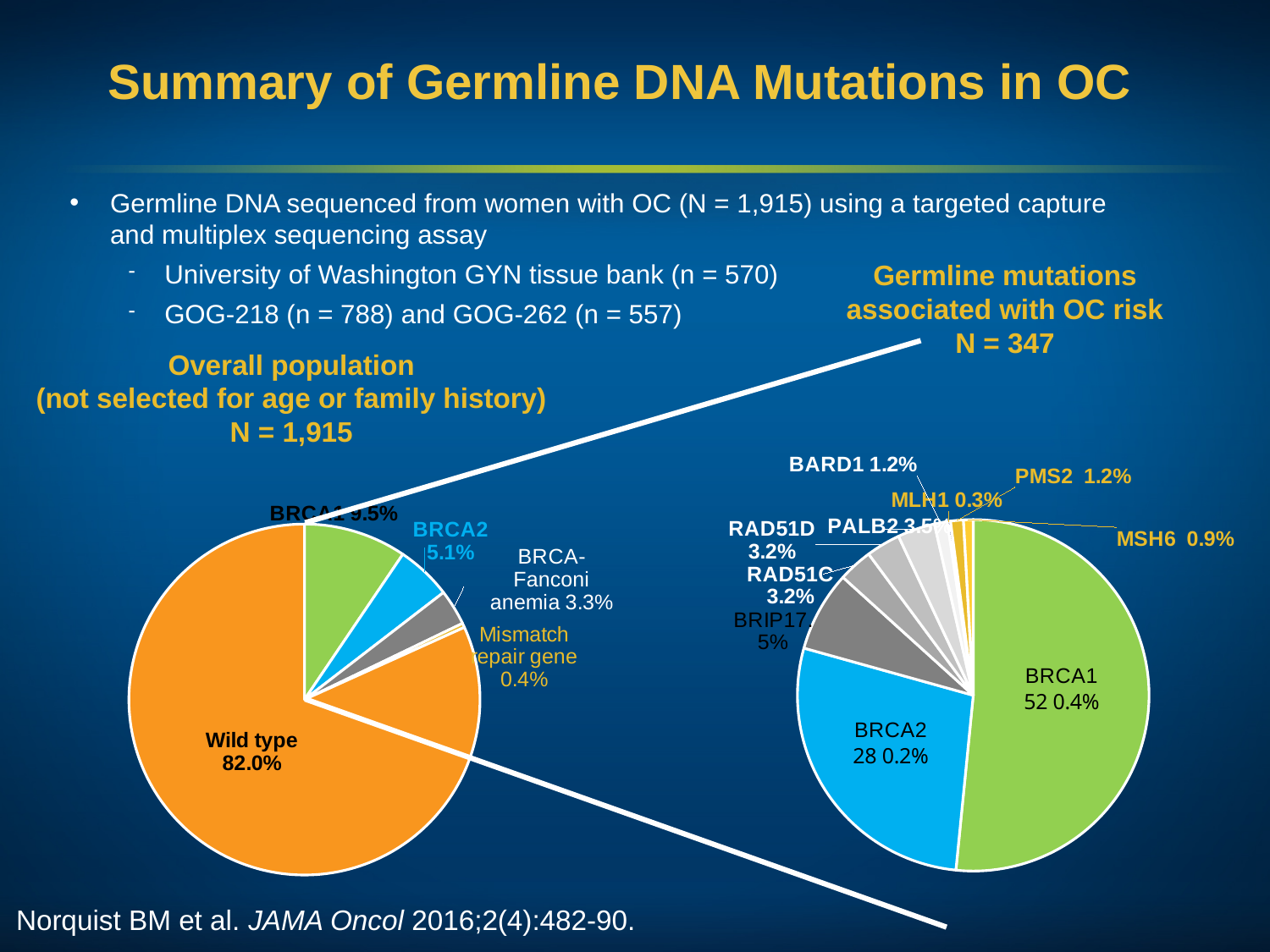
In the Germline mutations associated with OC risk pie chart on the right, what percentage is labelled for MSH6? 0.9% What kind of chart is used for the Overall population (N = 1,915) on the left of the slide? pie chart In the Overall population pie chart on the left, what percentage is labelled for BRCA2? 5.1% In the Germline mutations associated with OC risk pie chart on the right, which slice is the largest? BRCA1 In the Overall population pie chart on the left, what percentage is labelled for BRCA-Fanconi anemia? 3.3% In the Germline mutations associated with OC risk pie chart on the right, which slice is larger, BRCA1 or BRCA2? BRCA1 In the Germline mutations associated with OC risk pie chart on the right, what percentage is labelled for BARD1? 1.2% In the Overall population pie chart on the left, which slice is the smallest? Mismatch repair gene How many slices does the Overall population pie chart on the left have? 5 What is the N given for the Germline mutations associated with OC risk pie chart on the right? N = 347 In the Overall population pie chart on the left, what percentage is labelled for Wild type? 82.0% In the Overall population pie chart on the left, what is the difference between the Wild type and BRCA1 percentages? 72.5%